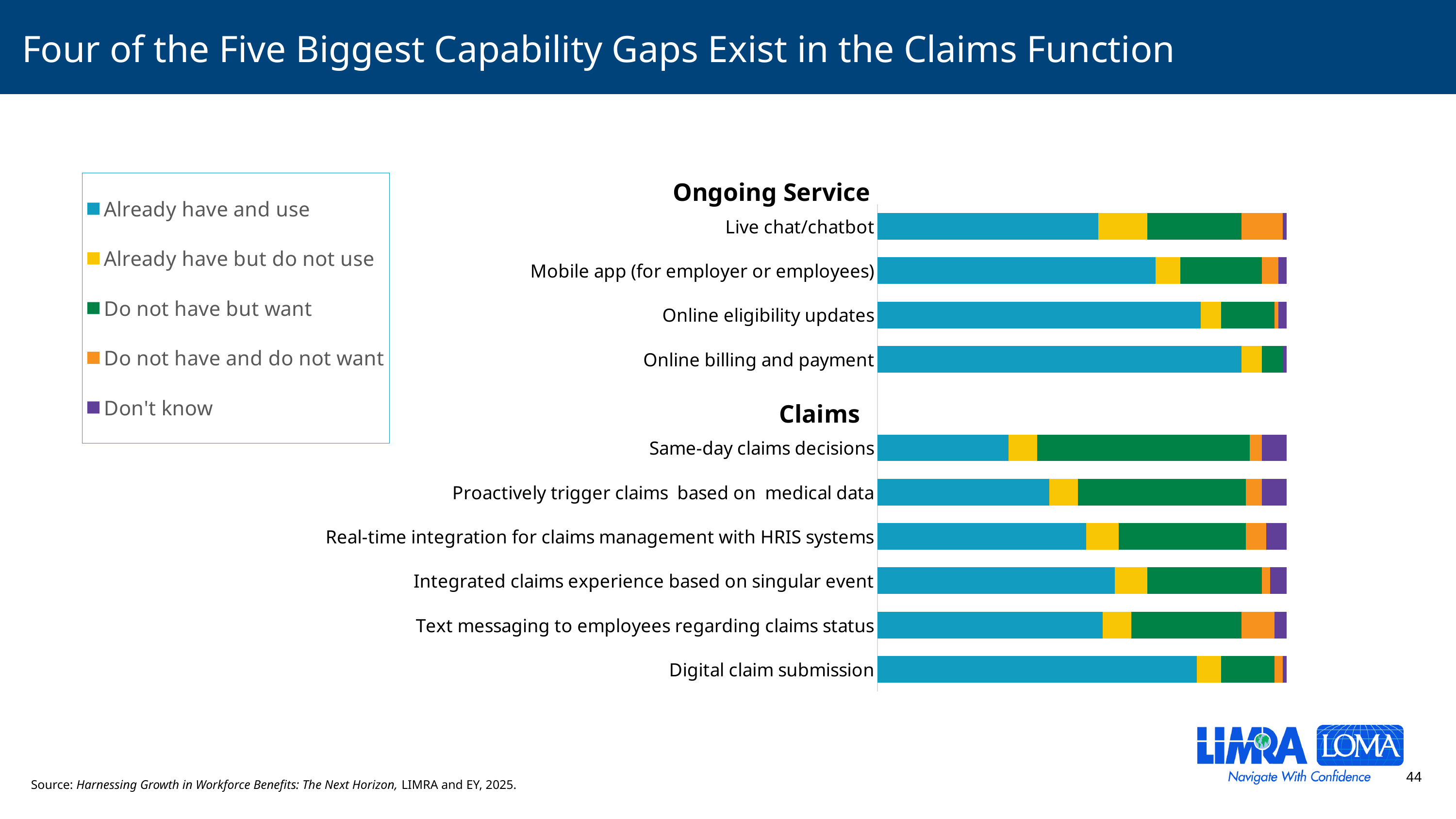
What are the two group headings used in the chart? Ongoing Service and Claims Is the 'Do not have but want' segment larger for Same-day claims decisions or for Digital claim submission? Same-day claims decisions How many capabilities are listed under the Claims group? 6 Is the 'Already have and use' segment larger for Online billing and payment or for Same-day claims decisions? Online billing and payment What kind of chart is shown on the slide? Stacked bar chart Which legend entry is shown in purple? Don't know How many capabilities are listed under the Ongoing Service group? 4 Which capability has the smallest 'Already have and use' segment? Same-day claims decisions Which capability has the largest 'Already have and use' segment? Online billing and payment How many series does the legend list? 5 Which capability has the largest 'Do not have but want' segment? Same-day claims decisions How many capabilities (bars) are plotted in the chart? 10